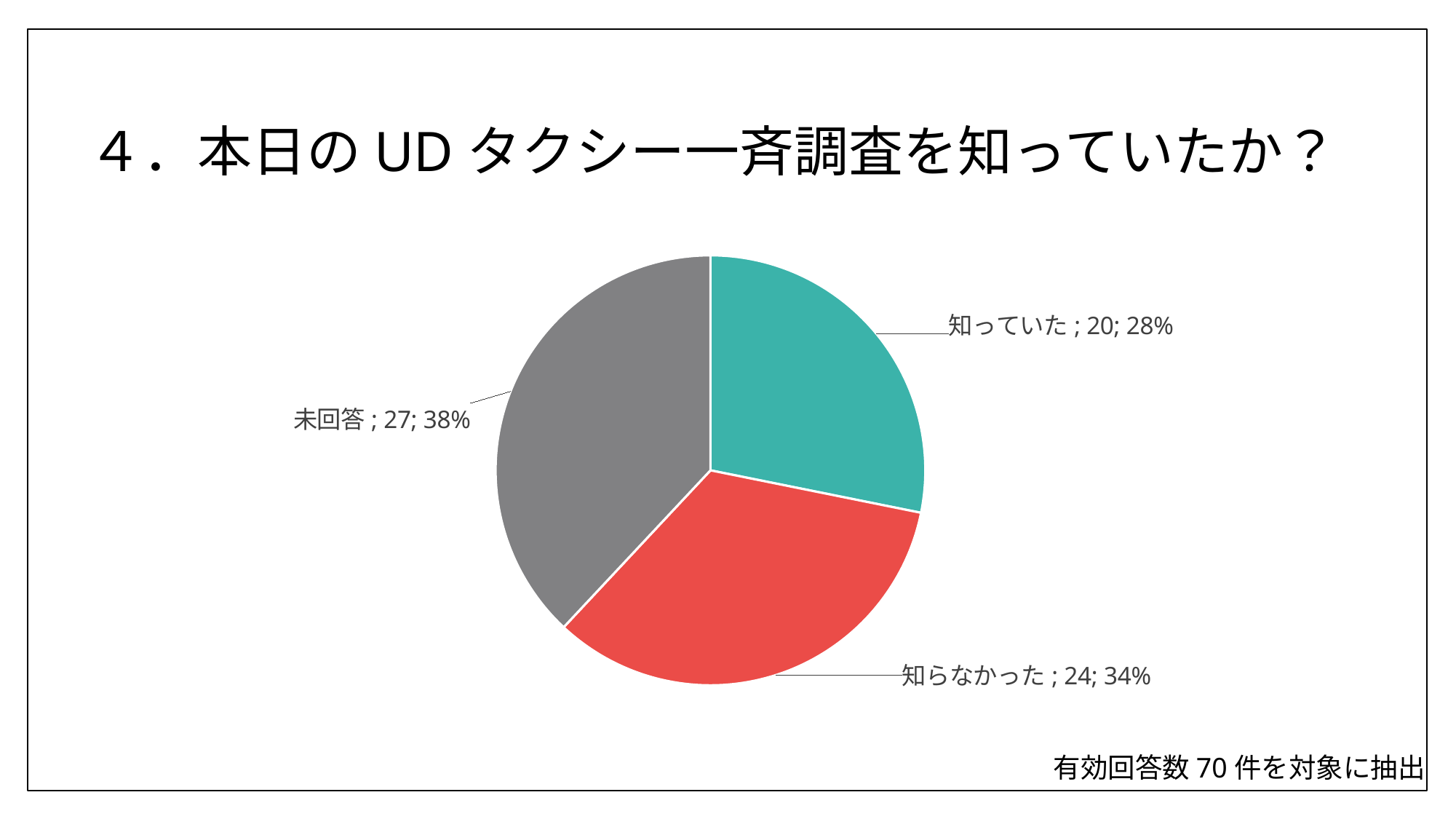
What share of the pie does 知っていた represent? 28% Which category has the smallest slice? 知っていた What colour is the 知らなかった slice? red What share of the pie does 未回答 represent? 38% What is the count for 未回答? 27 What is the count for 知っていた? 20 What kind of chart is shown on the slide? pie chart Which is larger, the count for 知らなかった or the count for 知っていた? 知らなかった What is the difference between the counts for 未回答 and 知っていた? 7 What is the count for 知らなかった? 24 How many slices does the pie chart have? 3 Which category has the largest slice? 未回答